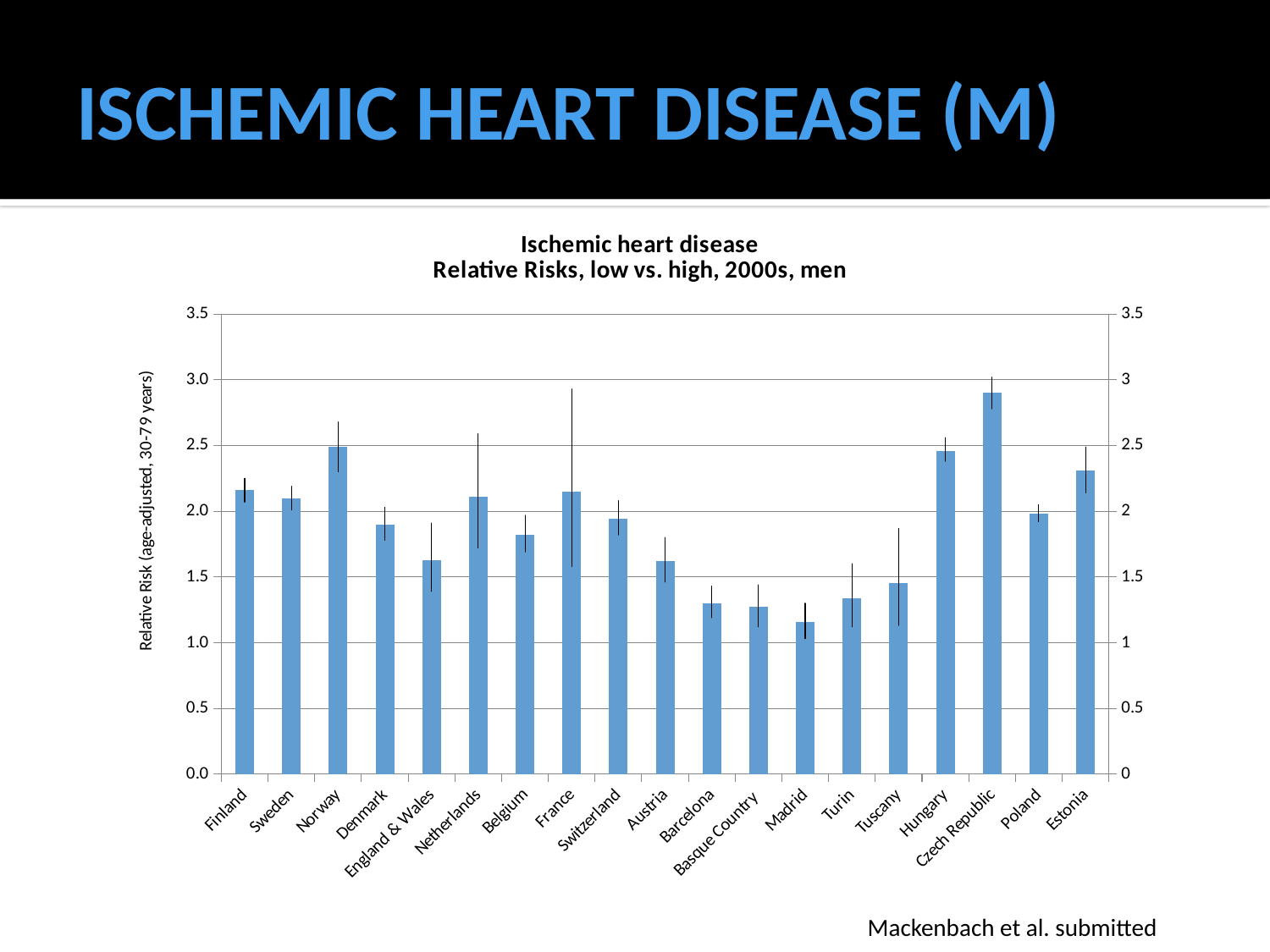
What is the title of the chart? Ischemic heart disease Relative Risks, low vs. high, 2000s, men Which has the larger relative risk, France or Belgium? France Is the value for Czech Republic greater or less than 2.5? greater Is the value for Belgium greater or less than 2.0? less Is the value for Estonia greater or less than 2.0? greater What is the label on the vertical axis of the chart? Relative Risk (age-adjusted, 30-79 years) Which has the larger relative risk, Norway or Denmark? Norway Which country or region has the highest relative risk in the chart? Czech Republic How many countries or regions are shown on the x axis of the chart? 19 What kind of chart is shown on the slide? bar chart Which country or region has the lowest relative risk in the chart? Madrid